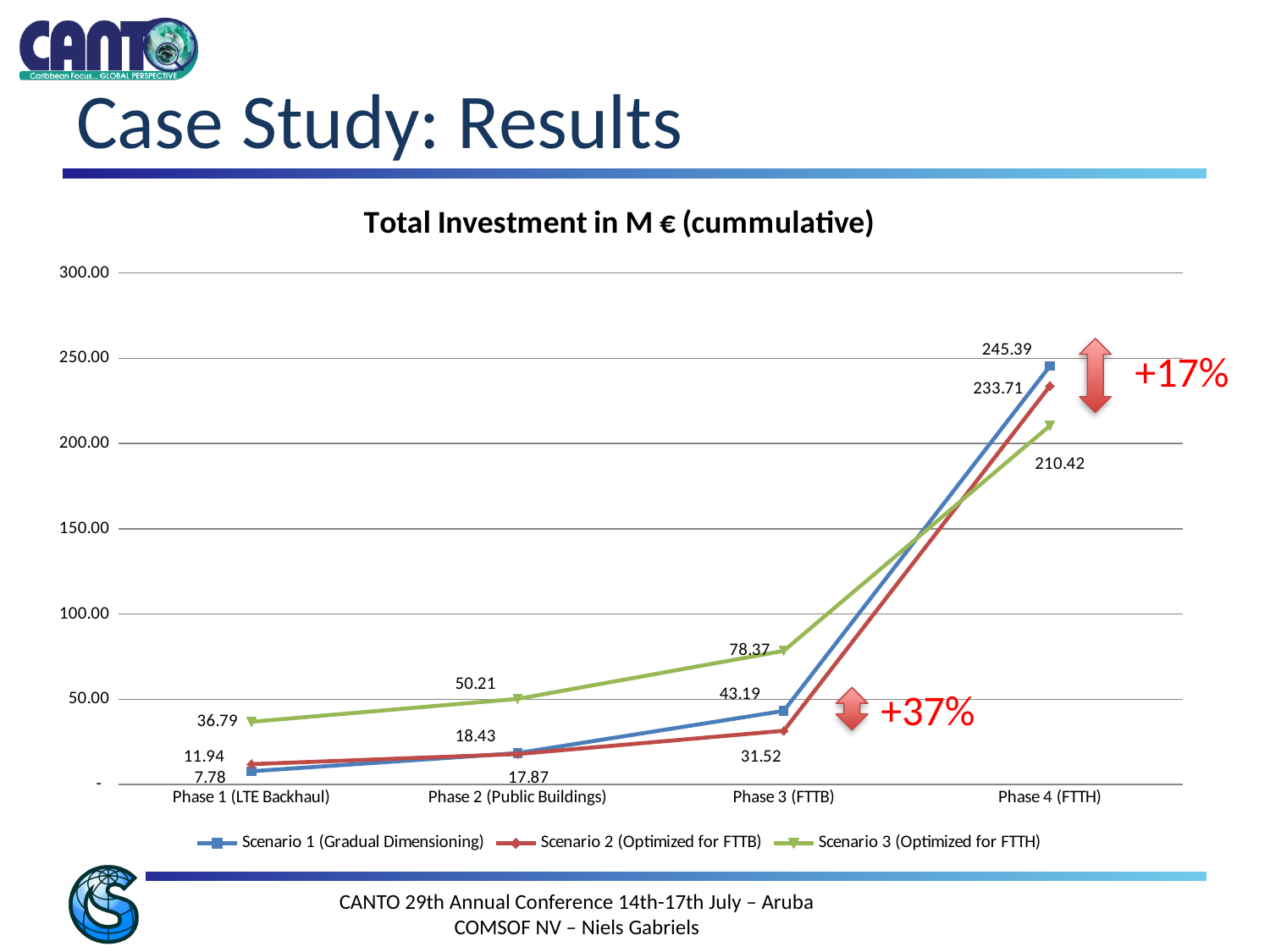
What kind of chart is shown on the slide? Line chart Which scenario has the lowest value at Phase 1 (LTE Backhaul)? Scenario 1 (Gradual Dimensioning) Which scenario has the highest value at Phase 4 (FTTH)? Scenario 1 (Gradual Dimensioning) What is the value for Scenario 3 (Optimized for FTTH) at Phase 3 (FTTB)? 78.37 At Phase 3 (FTTB), which is larger: Scenario 1 or Scenario 2? Scenario 1 (Gradual Dimensioning) What is the difference between Scenario 1 and Scenario 3 at Phase 4 (FTTH)? 34.97 What is the value for Scenario 1 (Gradual Dimensioning) at Phase 4 (FTTH)? 245.39 How many series does the legend list? 3 Does the value for Scenario 3 (Optimized for FTTH) rise or fall from Phase 1 to Phase 4? Rise What is the value for Scenario 2 (Optimized for FTTB) at Phase 1 (LTE Backhaul)? 11.94 For Scenario 3 (Optimized for FTTH), how much does the value increase from Phase 1 to Phase 2? 13.42 How many phases are shown on the x axis? 4